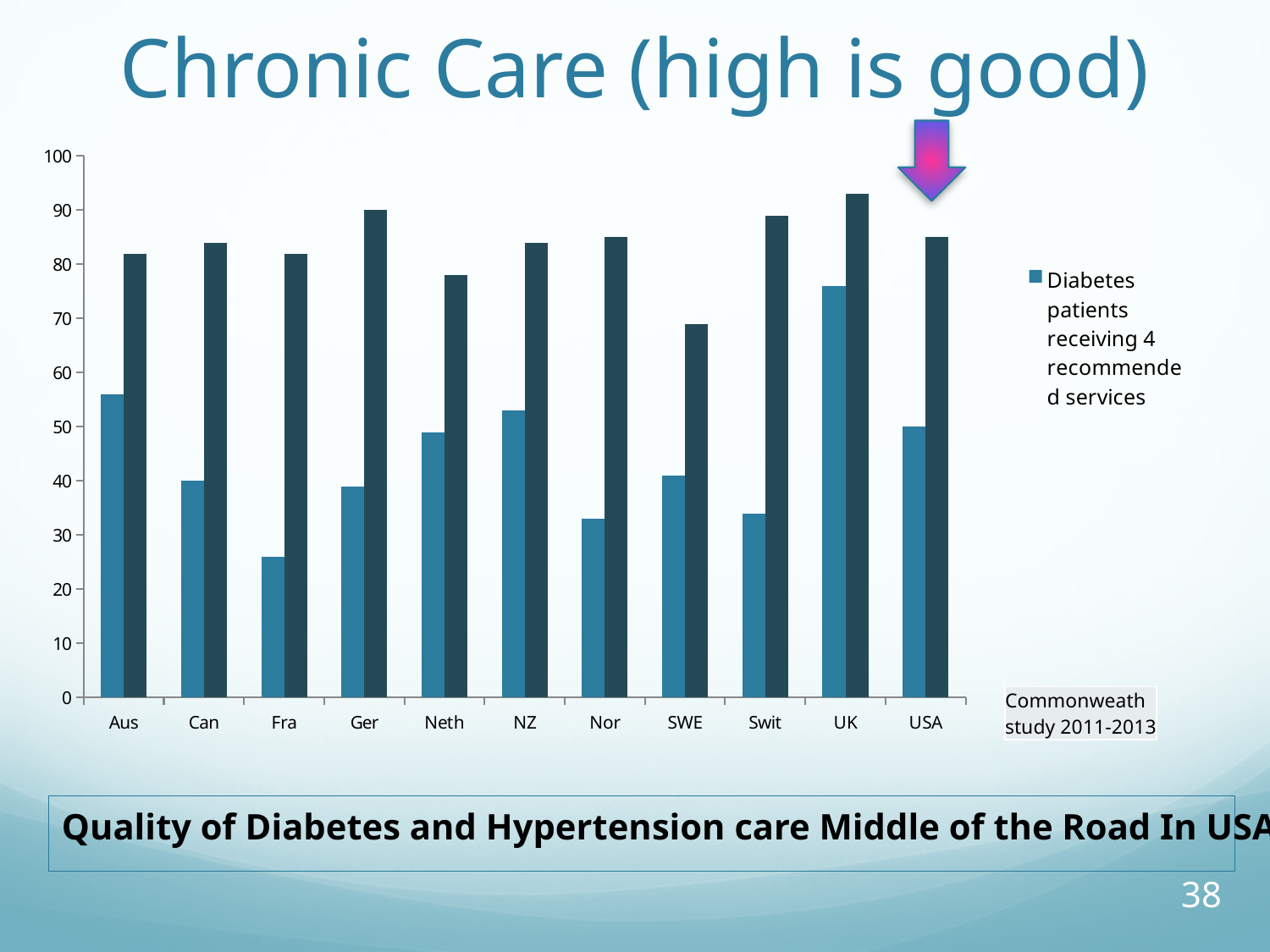
Is the light blue bar for Fra greater or less than 30? less What type of chart is shown on the slide? bar chart What series name does the legend show for the light blue bars? Diabetes patients receiving 4 recommended services Which country has the shortest dark bar in the chart? SWE Which is larger, the light blue bar for Aus or the light blue bar for Can? Aus What is the title of the chart slide? Chronic Care (high is good) Is the dark bar for UK greater or less than 90? greater Which country has the tallest light blue bar (Diabetes patients receiving 4 recommended services)? UK How many countries are shown on the x axis of the chart? 11 Which country has the shortest light blue bar (Diabetes patients receiving 4 recommended services)? Fra